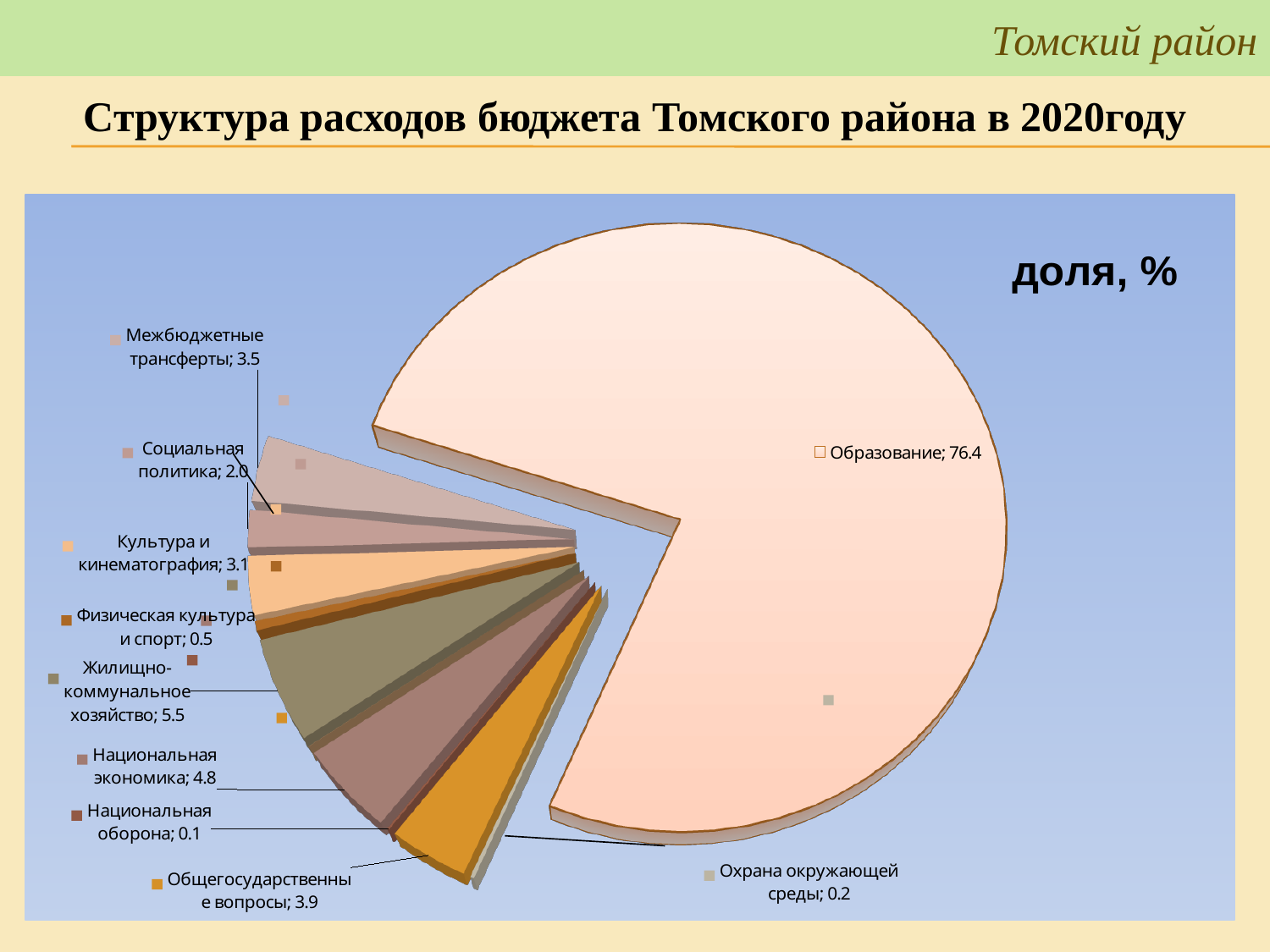
What is the value for Охрана окружающей среды? 0.2 What is the value for Образование? 76.4 What is the title of the chart? доля, % What is the value for Жилищно-коммунальное хозяйство? 5.5 What is the value for Национальная экономика? 4.8 What is the difference between the values for Жилищно-коммунальное хозяйство and Национальная экономика? 0.7 Which category has the largest share of the pie? Образование What kind of chart is shown on the slide? pie chart What unit label is shown in the top right of the chart area? доля, % Which is larger, Межбюджетные трансферты or Культура и кинематография? Межбюджетные трансферты